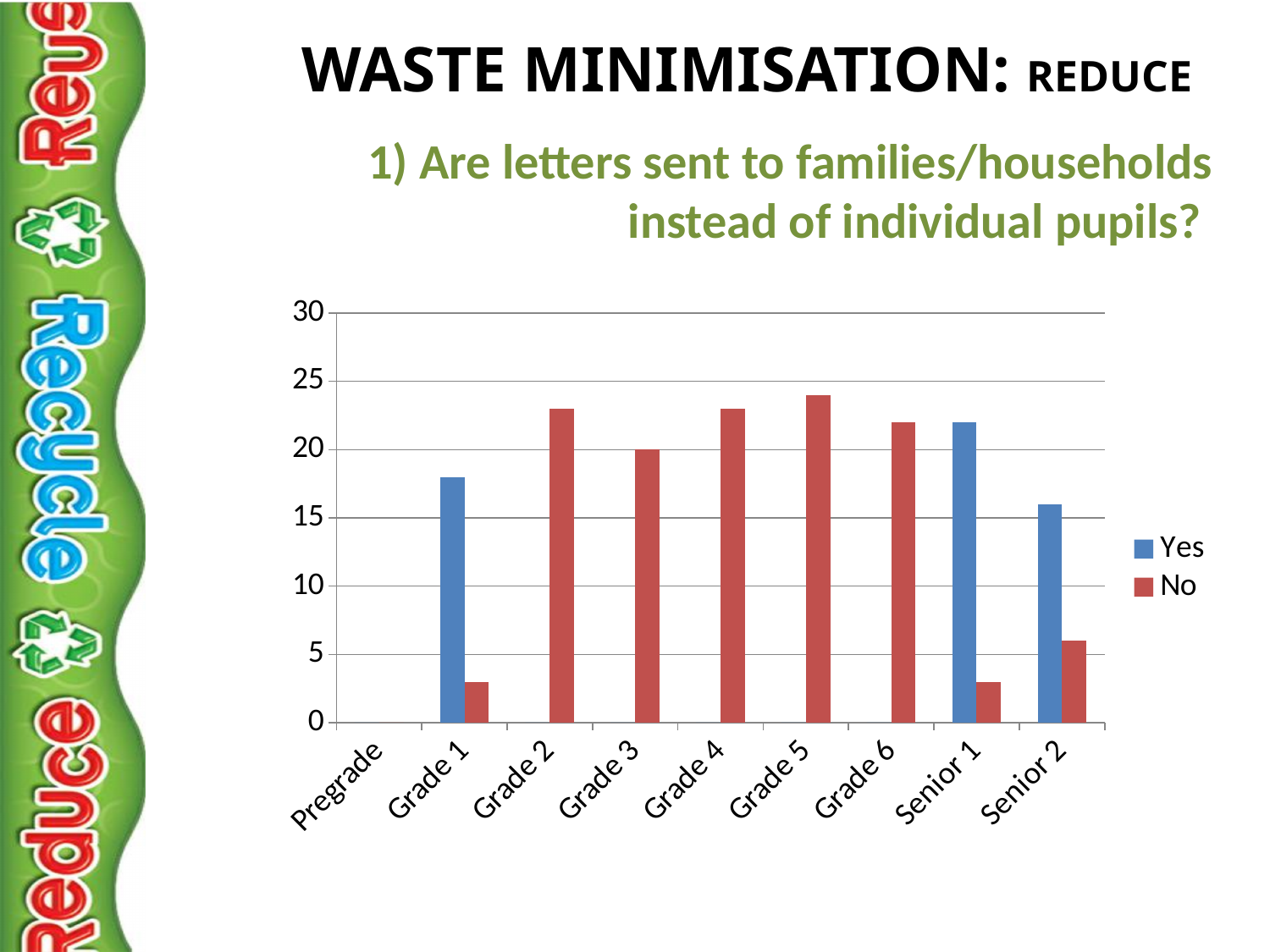
Which category has the lowest 'No' value among those with a visible 'No' bar? Grade 1 and Senior 1 (tied) For Senior 2, which is larger, the 'Yes' value or the 'No' value? Yes What kind of chart is shown on the slide? bar chart Which category shows no bars at all? Pregrade What colour represents the 'No' series in the legend? red Is the 'No' value for Grade 1 greater or less than 5? less Is the 'Yes' value for Grade 1 greater or less than 15? greater Which category has the highest 'Yes' value? Senior 1 Is the 'Yes' value for Senior 1 greater or less than 20? greater How many series does the legend list? 2 How many categories are shown on the x axis? 9